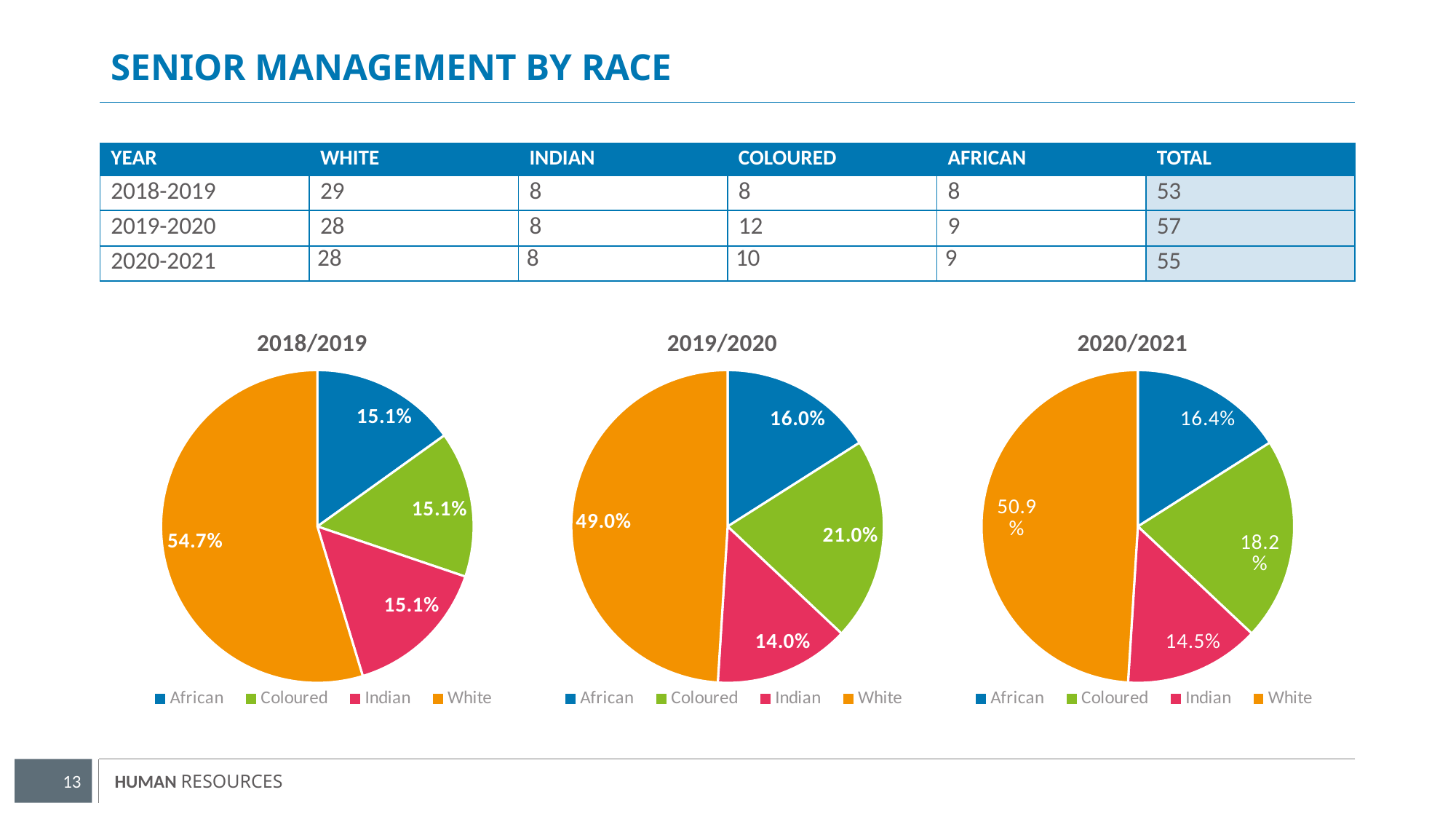
How many slices does the 2018/2019 pie chart have? 4 In the 2018/2019 pie chart, what colour is the White slice? Orange In the 2018/2019 pie chart, what share does the White slice have? 54.7% What type of chart is used for 2020/2021? Pie chart In the 2020/2021 pie chart, which slice is larger, Coloured or African? Coloured In the 2020/2021 pie chart, what share does the Indian slice have? 14.5% How many entries does the legend of the 2019/2020 chart list? 4 In the 2019/2020 pie chart, what share does the Coloured slice have? 21.0% In the 2019/2020 pie chart, which category has the smallest slice? Indian In the 2020/2021 pie chart, which category has the largest slice? White In the 2020/2021 pie chart, what share does the African slice have? 16.4% In the 2019/2020 pie chart, what is the difference between the White share and the Coloured share? 28.0%